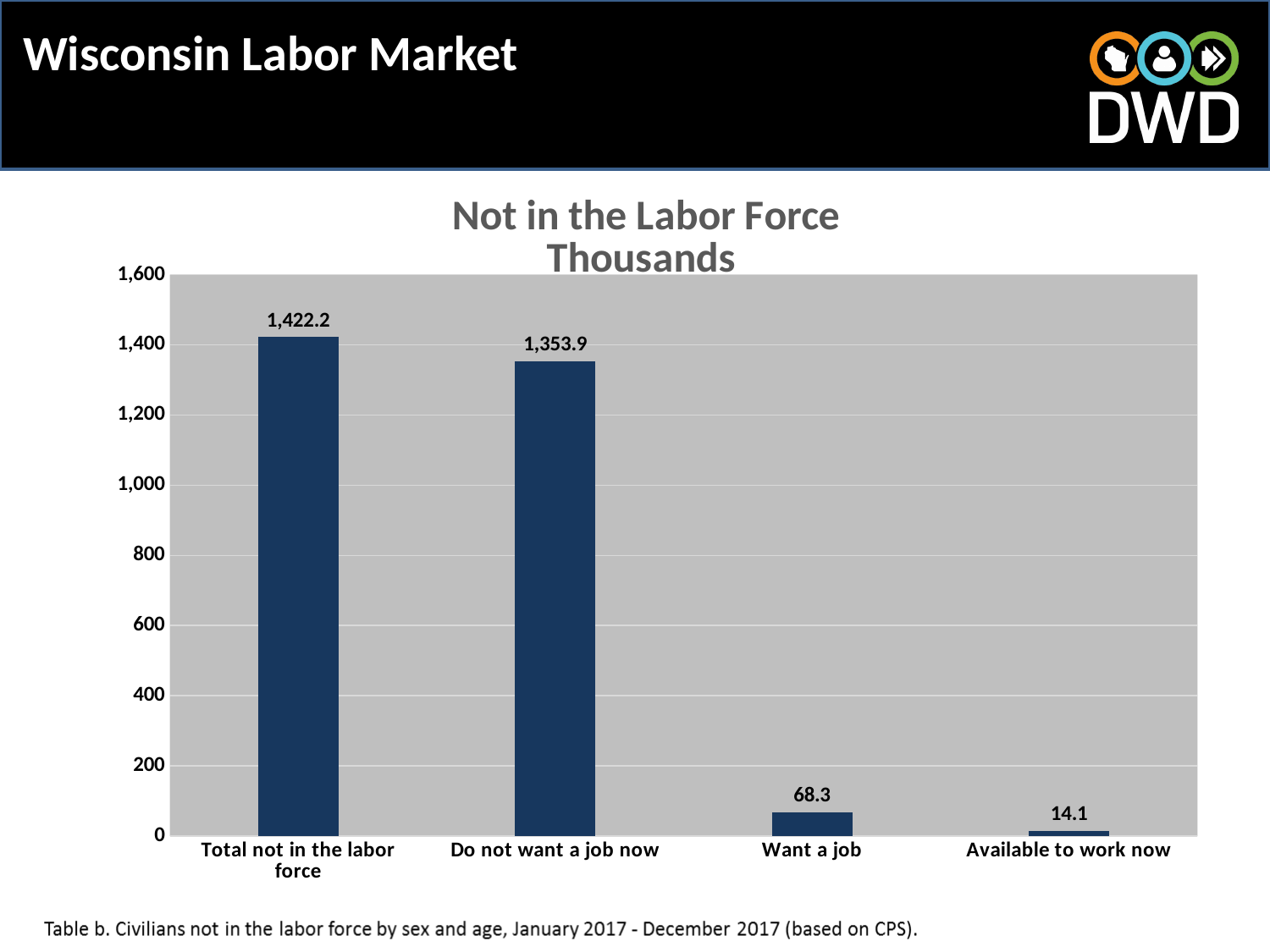
What is the difference between 'Total not in the labor force' and 'Do not want a job now'? 68.3 What is the value for 'Total not in the labor force'? 1,422.2 What is the title of the chart? Not in the Labor Force Thousands What is the value for 'Available to work now'? 14.1 What is the value for 'Want a job'? 68.3 How many categories are shown on the chart? 4 Which category has the lowest value? Available to work now Which category has the highest value? Total not in the labor force Which is larger, 'Want a job' or 'Available to work now'? Want a job What kind of chart is this? Bar chart What is the value for 'Do not want a job now'? 1,353.9 What is the difference between 'Want a job' and 'Available to work now'? 54.2